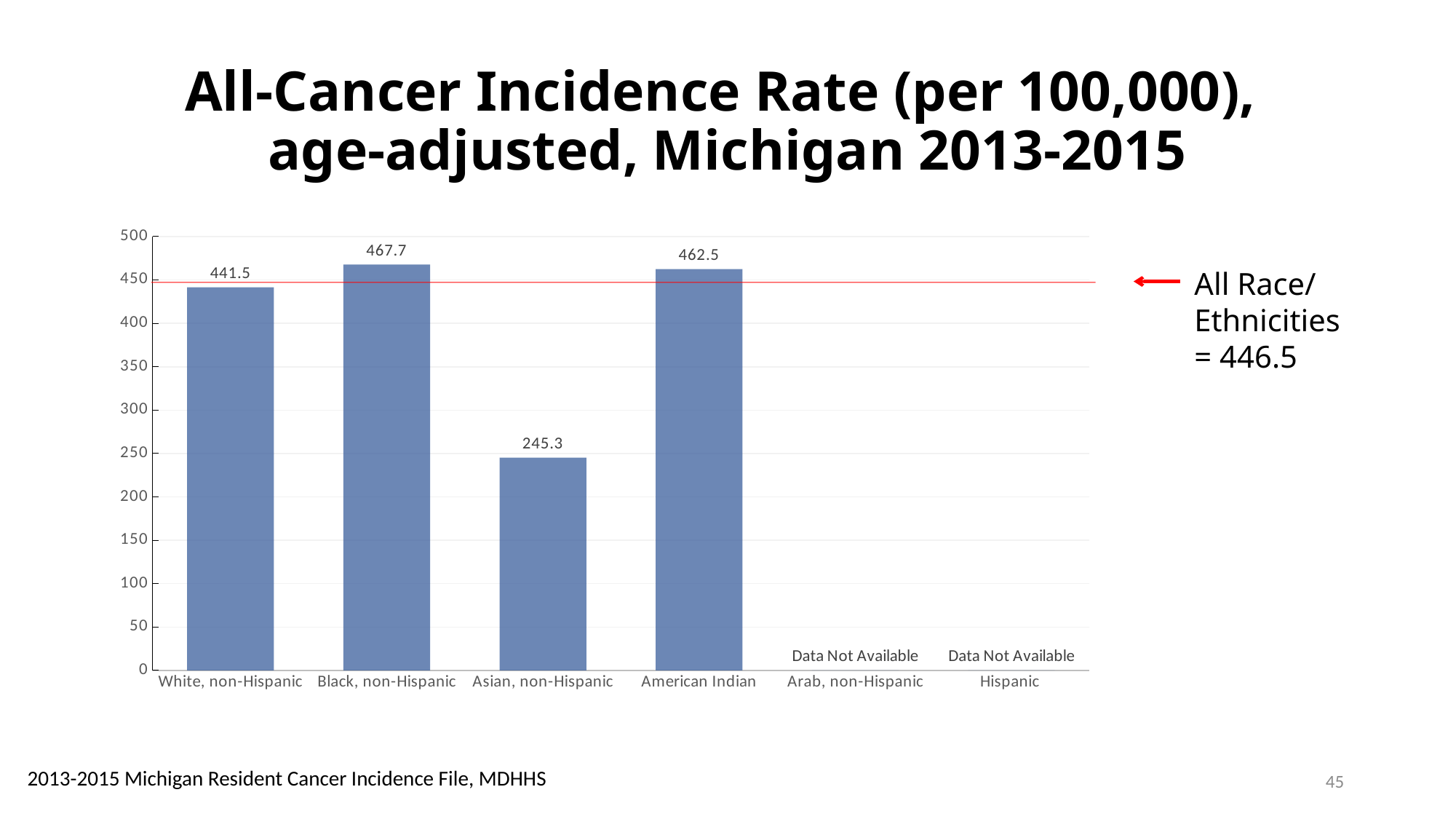
What is the all-cancer incidence rate for Asian, non-Hispanic? 245.3 Which categories are marked as 'Data Not Available'? Arab, non-Hispanic and Hispanic What is the All Race/Ethnicities rate indicated by the red line? 446.5 Which group has the highest all-cancer incidence rate? Black, non-Hispanic How many categories are shown on the x axis? 6 What is the all-cancer incidence rate for American Indian? 462.5 What is the difference between the incidence rates for Black, non-Hispanic and Asian, non-Hispanic? 222.4 What kind of chart is shown on the slide? Bar chart What is the all-cancer incidence rate for Black, non-Hispanic? 467.7 Which group with a plotted value has the lowest all-cancer incidence rate? Asian, non-Hispanic Which is larger, the incidence rate for White, non-Hispanic or for American Indian? American Indian What is the all-cancer incidence rate for White, non-Hispanic? 441.5